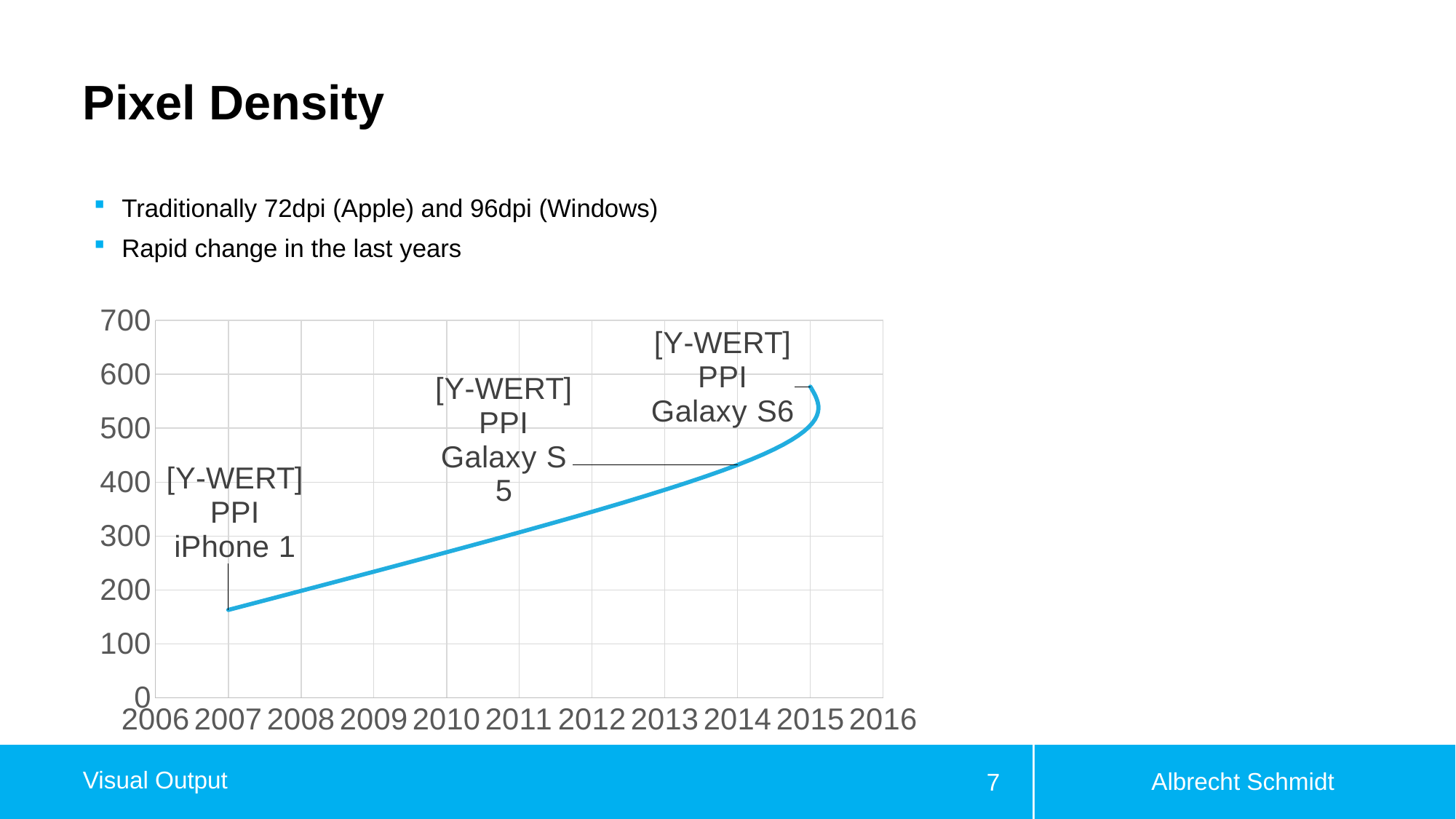
What kind of chart is shown on the slide? line chart Which labeled device has the lowest PPI value? iPhone 1 Which labeled device has the highest PPI value? Galaxy S6 Is the PPI value for the iPhone 1 greater or less than 200? less Which has the larger PPI value, the Galaxy S5 or the iPhone 1? Galaxy S5 How many labeled data points does the chart show? 3 Which device is labeled at the 2007 data point? iPhone 1 Is the PPI value for the Galaxy S5 greater or less than 400? greater What is the highest value shown on the y axis? 700 Do the PPI values rise or fall from 2007 to 2015? rise Is the PPI value for the Galaxy S6 greater or less than 500? greater